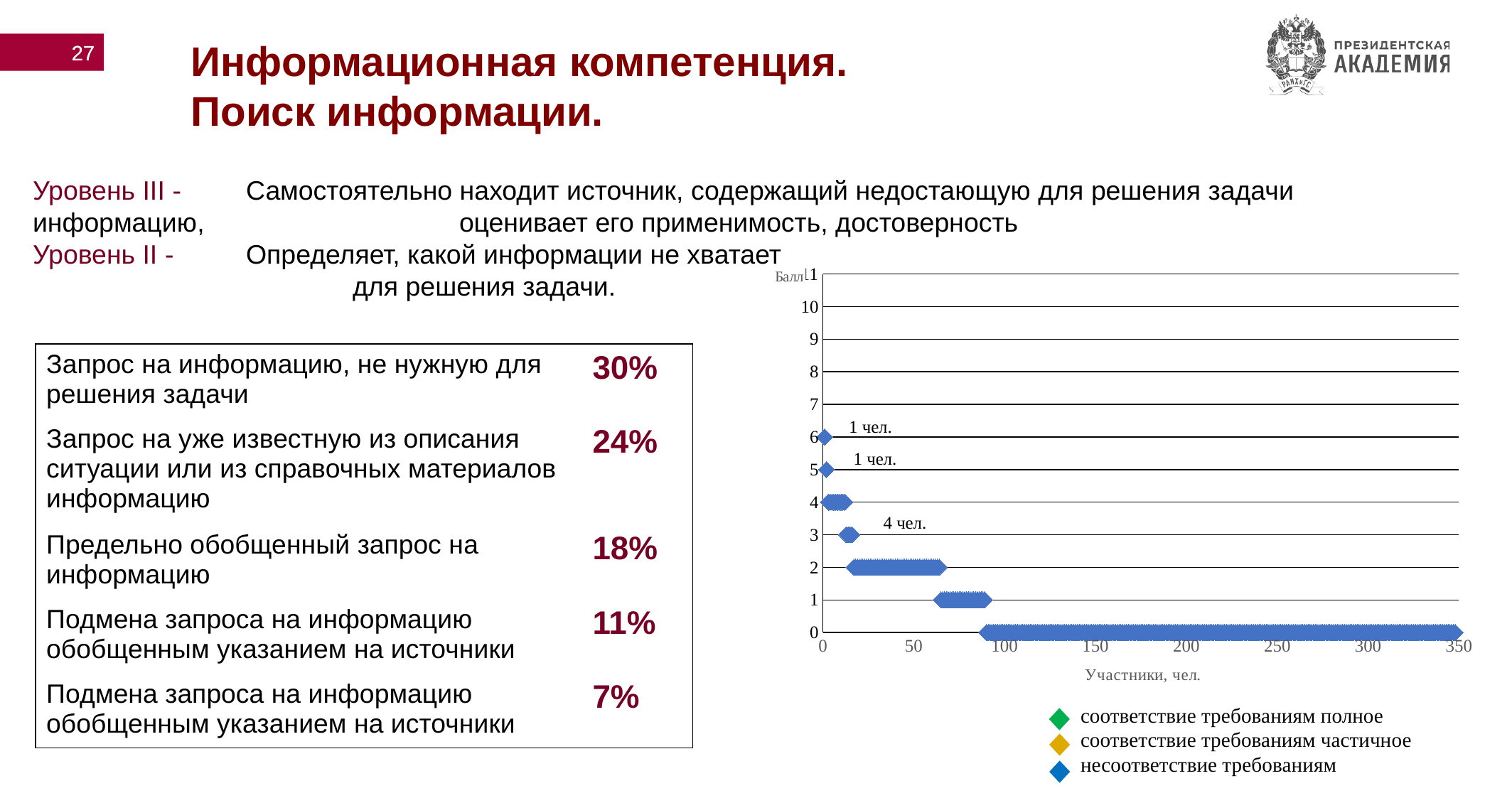
What is the data label shown next to the marker at score 6 (Балл 6)? 1 чел. What is the data label shown next to the marker at score 5 (Балл 5)? 1 чел. What is the title of the x axis? Участники, чел. Which score has more participants plotted: score 2 or score 1? score 2 What is the data label shown next to the marker at score 3 (Балл 3)? 4 чел. How many data labels with participant counts are printed on the chart? 3 What kind of chart is shown on the slide? scatter chart How many series does the chart legend list? 3 What is the highest score (Балл) at which any marker is plotted? 6 Which score (Балл) has the largest number of participants plotted? 0 What is the highest tick value shown on the x axis? 350